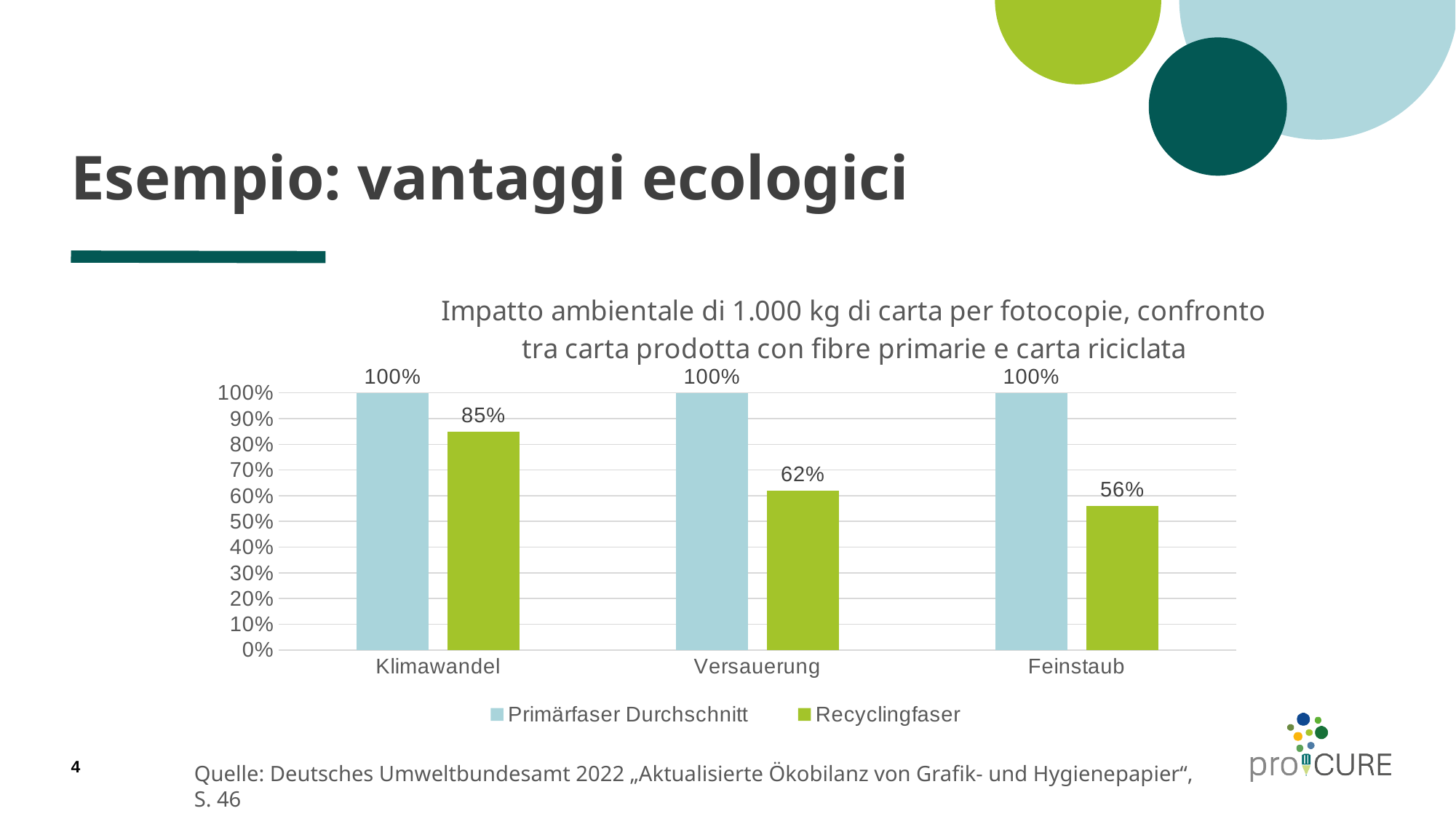
Which is larger in the Versauerung category: Primärfaser Durchschnitt or Recyclingfaser? Primärfaser Durchschnitt What is the difference between the Recyclingfaser values for Klimawandel and Versauerung? 23% How many series does the legend list? 2 What kind of chart is shown on the slide? Bar chart In which category is the Recyclingfaser value highest? Klimawandel What is the value for Recyclingfaser in the Klimawandel category? 85% In which category is the Recyclingfaser value lowest? Feinstaub What is the difference between Primärfaser Durchschnitt and Recyclingfaser in the Feinstaub category? 44% How many categories are shown on the x axis? 3 What is the value for Primärfaser Durchschnitt in the Versauerung category? 100% What is the value for Recyclingfaser in the Versauerung category? 62% What is the value for Recyclingfaser in the Feinstaub category? 56%